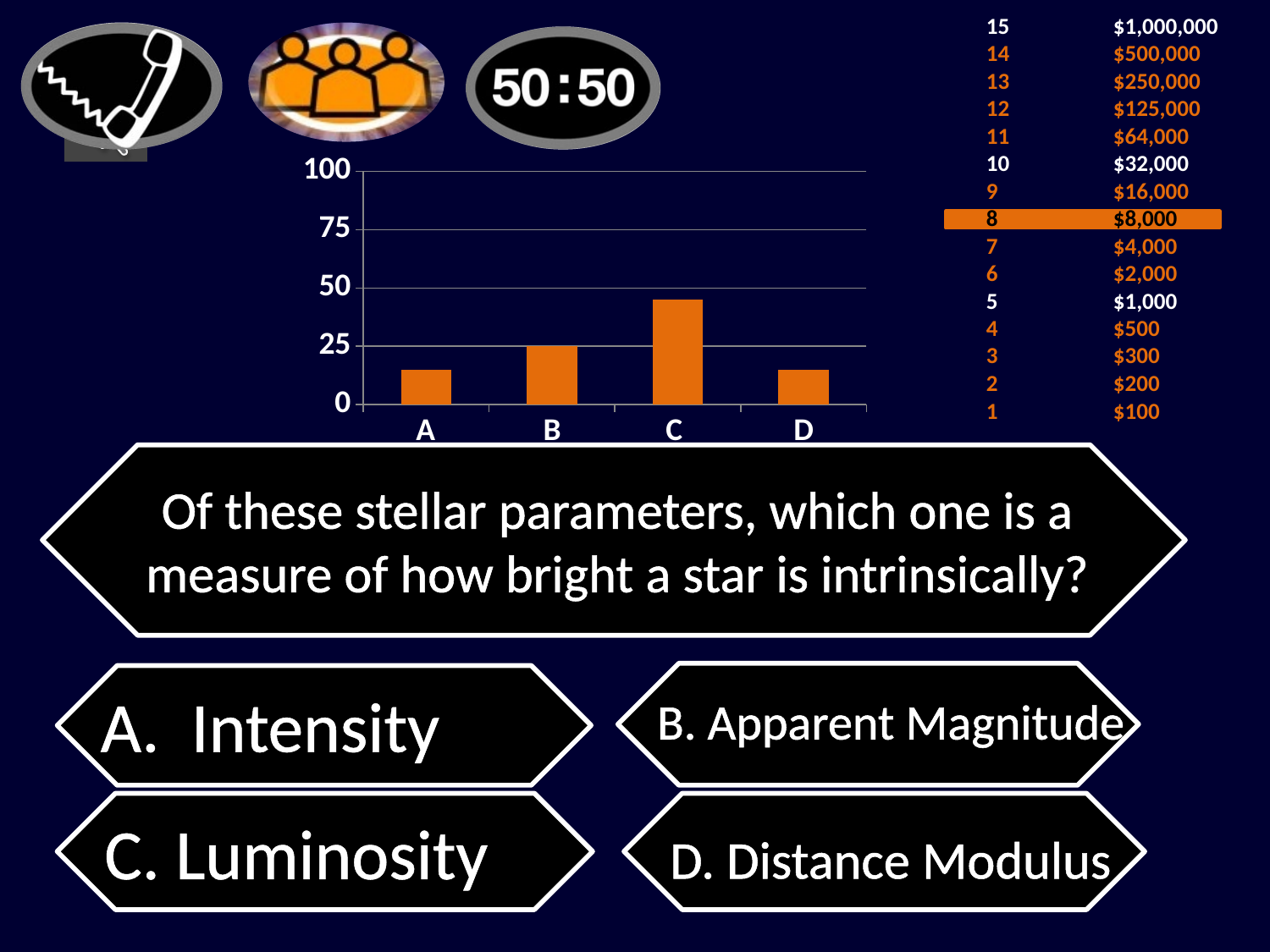
Is the value for D greater or less than 25? less What kind of chart is shown on the slide? bar chart What colour are the bars in the chart? orange What is the value for B in the bar chart? 25 Is the value for C greater or less than 25? greater Is the value for C greater or less than 50? less Which is larger, the value for A or the value for B? B What is the maximum value shown on the y axis of the chart? 100 Which category has the highest bar in the chart? C Which is larger, the value for B or the value for C? C How many categories are shown on the x axis of the bar chart? 4